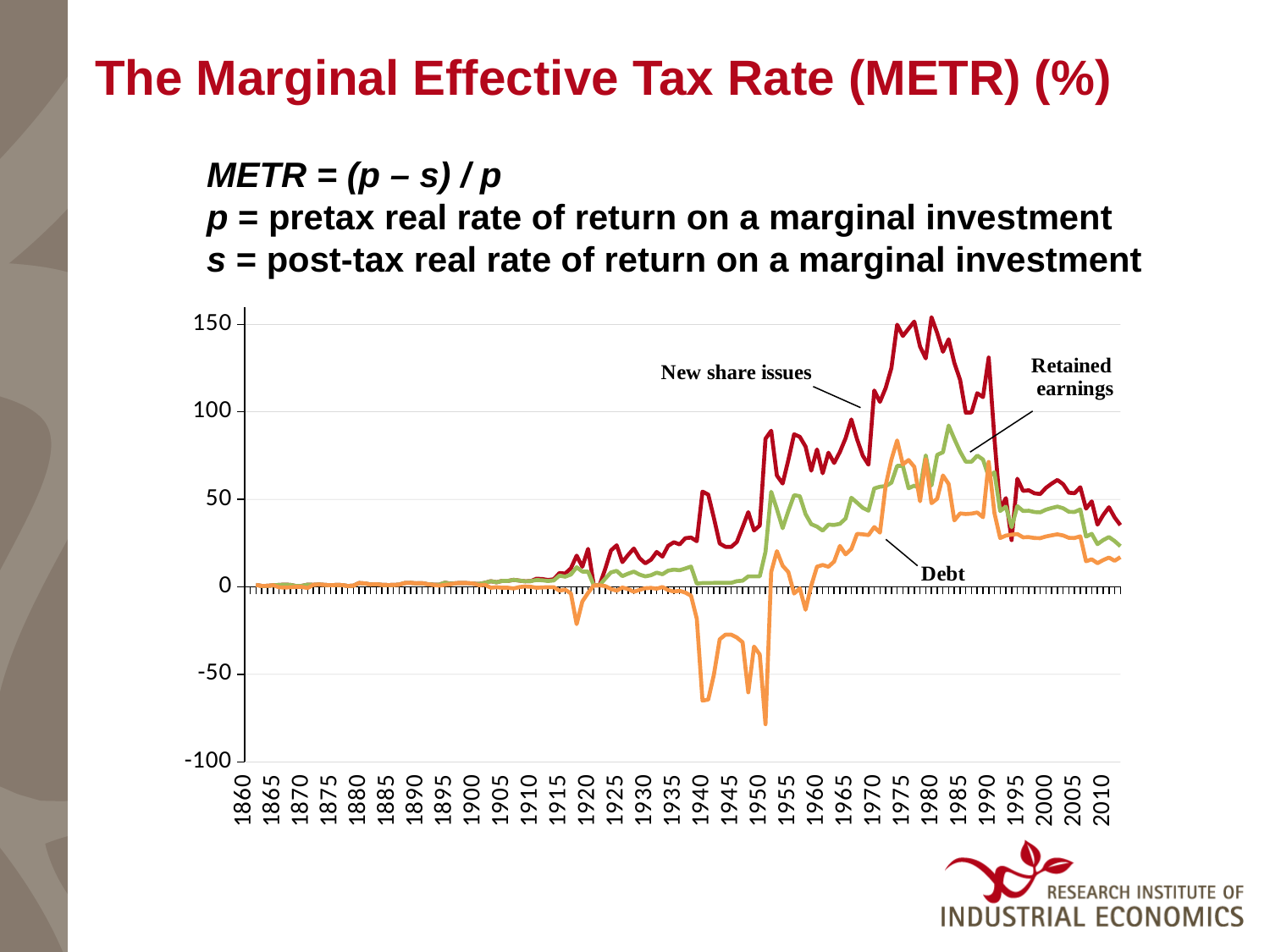
Does the New share issues series rise or fall between 1990 and 2010? fall What is the first year labelled on the x axis? 1860 How many data series are labelled on the chart? 3 Is the value for Retained earnings in 1900 greater or less than 50? less Is the lowest value for Debt (around 1950) greater or less than -50? less Which series reaches the lowest (most negative) value on the chart? Debt Which series reaches the highest value on the chart? New share issues Is the peak value for Retained earnings around 1985 greater or less than 50? greater What colour is the line for New share issues? red Around 1980, which series has the larger value, New share issues or Debt? New share issues What kind of chart is shown on the slide? line chart